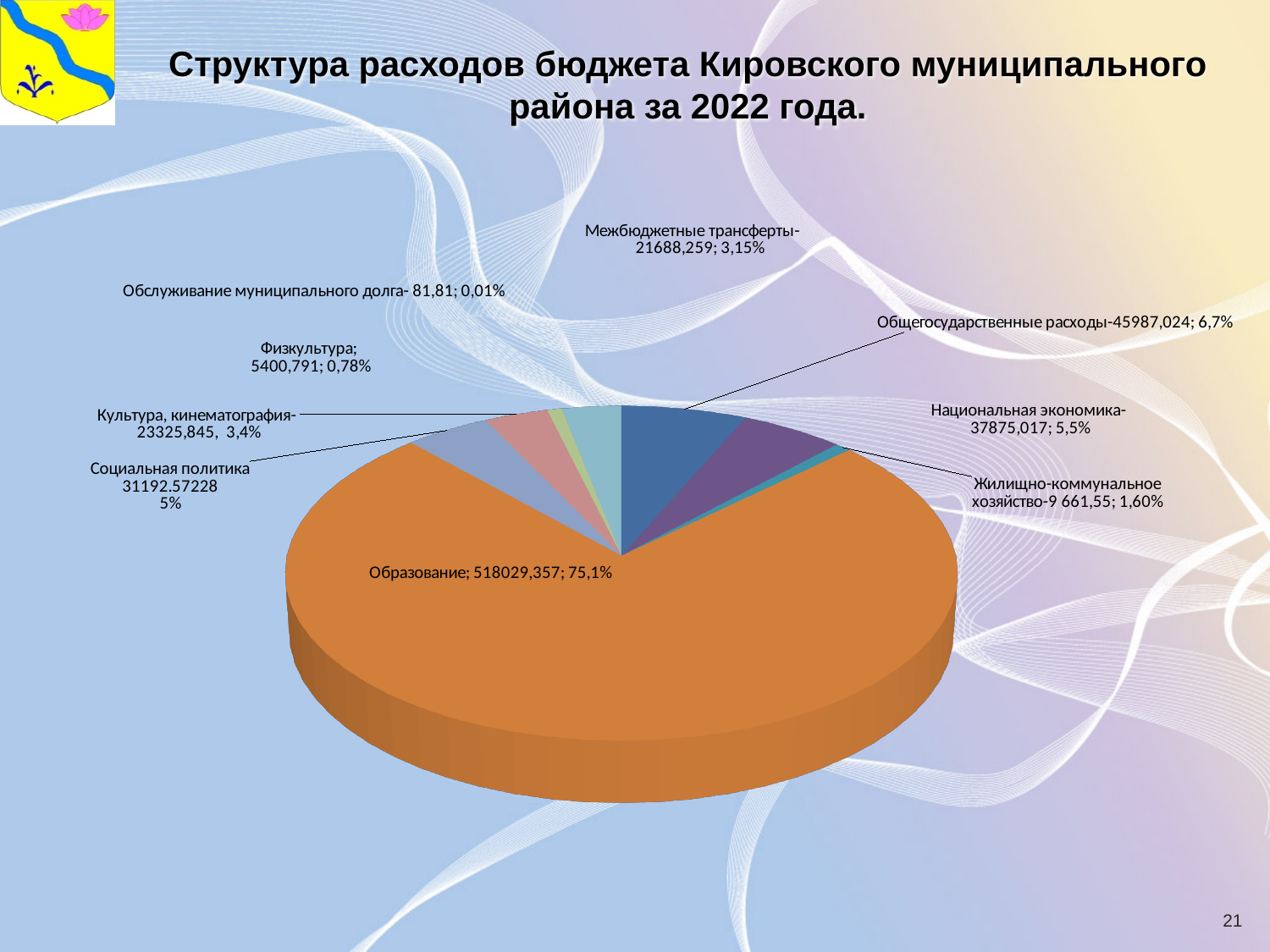
What share of the pie does Образование account for? 75,1% What is the title of the chart on the slide? Структура расходов бюджета Кировского муниципального района за 2022 года. How many categories (slices) does the pie chart show? 9 Which category has the smallest slice of the pie? Обслуживание муниципального долга What is the value shown for Общегосударственные расходы? 45987,024 Which category has the largest slice of the pie? Образование What is the value shown for Межбюджетные трансферты? 21688,259 What is the value shown for Образование? 518029,357 What share of the pie does Национальная экономика account for? 5,5% Which is larger: Культура, кинематография or Физкультура? Культура, кинематография What share of the pie does Жилищно-коммунальное хозяйство account for? 1,60% What kind of chart is shown on the slide? pie chart